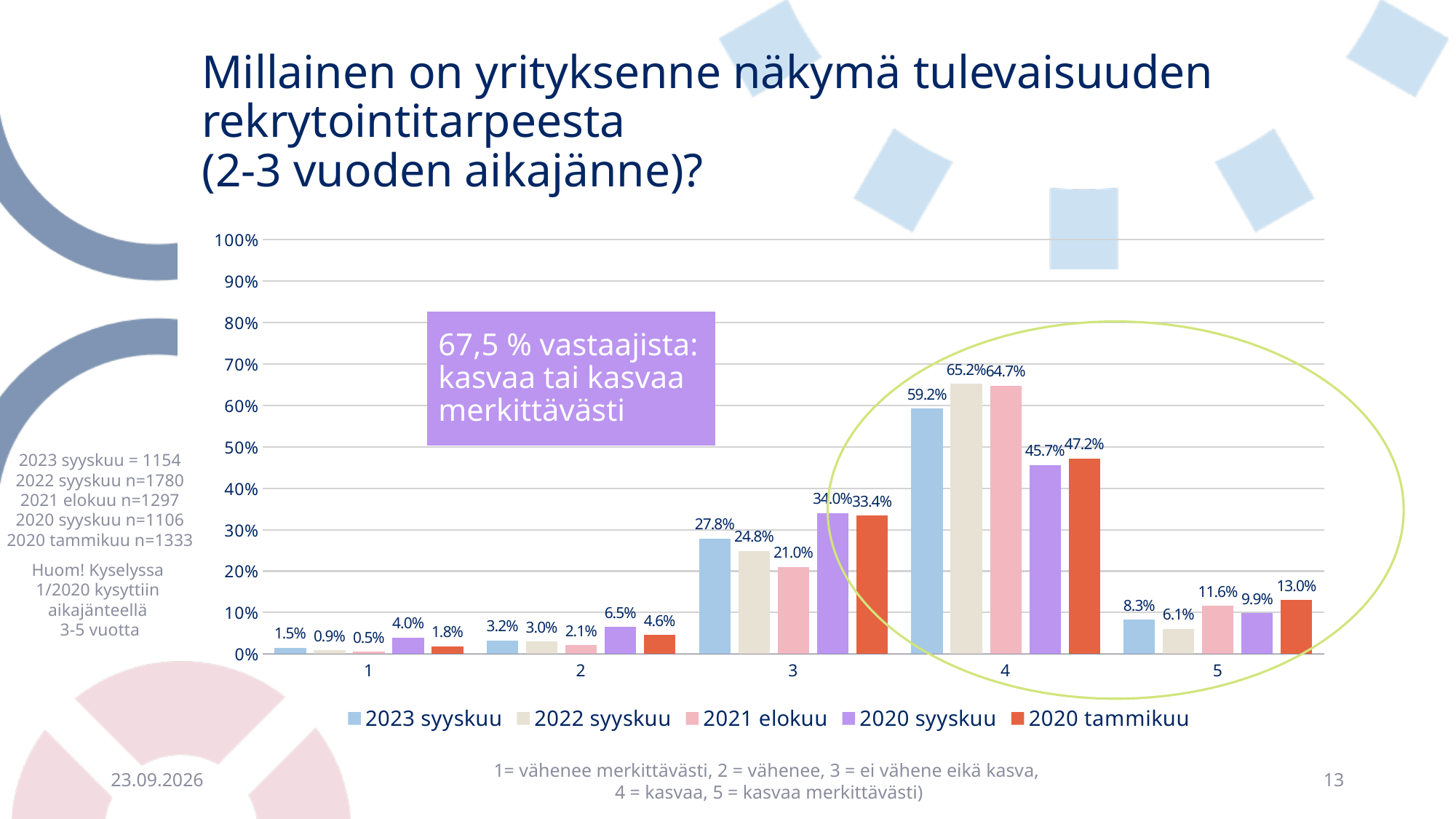
What kind of chart is shown on the slide? Bar chart Which series has the lowest value in category 1? 2021 elokuu What is the value for 2020 tammikuu in category 5? 13.0% What is the value for 2020 syyskuu in category 3? 34.0% What is the difference between the 2022 syyskuu and 2020 syyskuu values in category 4? 19.5% How many categories are shown on the x axis? 5 What is the value for 2023 syyskuu in category 4? 59.2% How many series does the legend list? 5 What is the value for 2021 elokuu in category 5? 11.6% What is the value for 2020 tammikuu in category 1? 1.8% Which is larger in category 3: the value for 2023 syyskuu or the value for 2021 elokuu? 2023 syyskuu Which series has the highest value in category 4? 2022 syyskuu